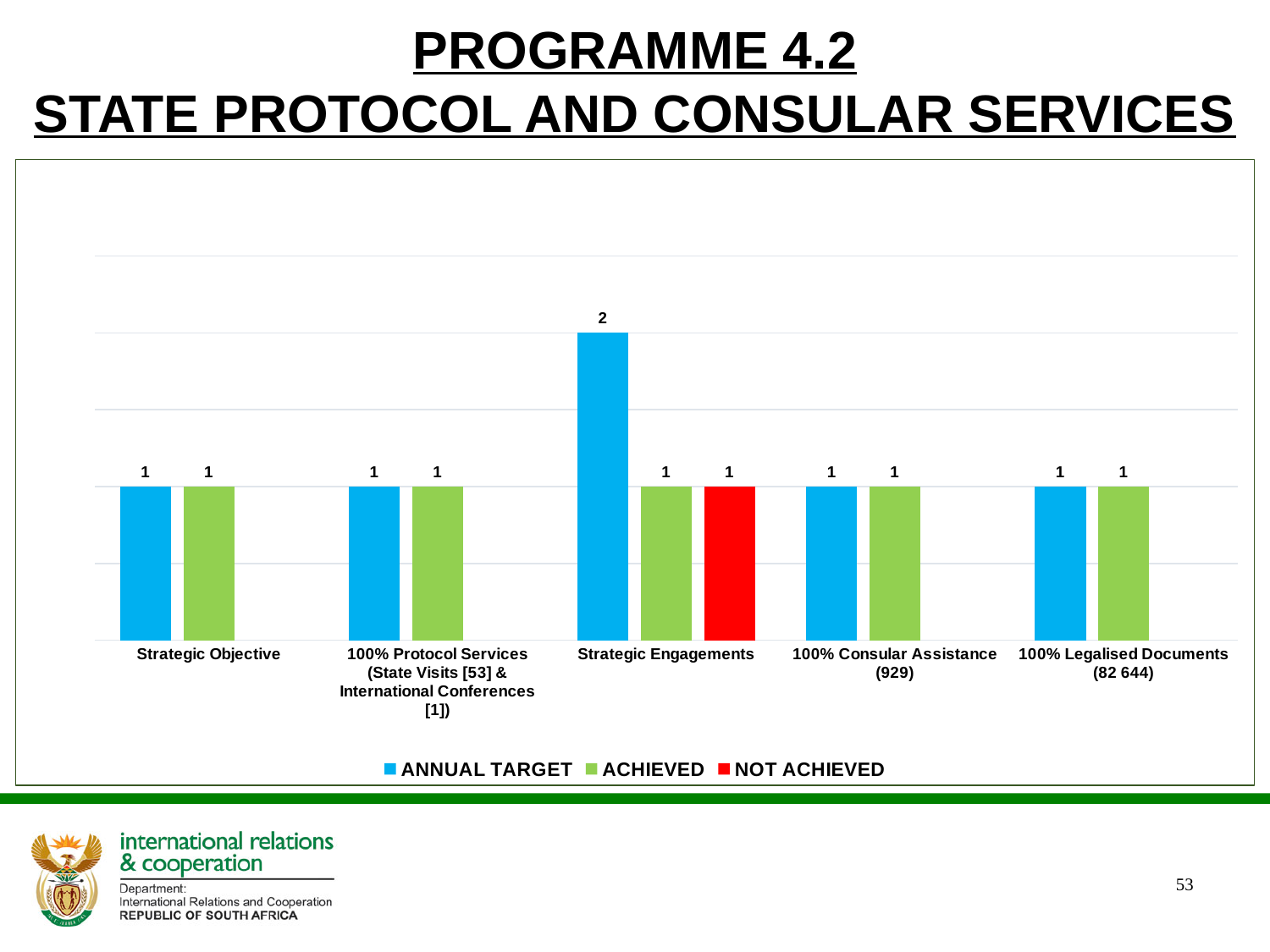
How many categories are shown on the x axis? 5 Which category is the only one with a NOT ACHIEVED bar? Strategic Engagements Which is larger for Strategic Engagements: the ANNUAL TARGET or the ACHIEVED value? ANNUAL TARGET Which category has the highest ANNUAL TARGET value? Strategic Engagements What is the ANNUAL TARGET value for Strategic Engagements? 2 What is the ANNUAL TARGET value for 100% Legalised Documents (82 644)? 1 What is the NOT ACHIEVED value for Strategic Engagements? 1 What is the difference between the ANNUAL TARGET and ACHIEVED values for Strategic Engagements? 1 What kind of chart is shown on the slide? Bar chart What is the ACHIEVED value for 100% Consular Assistance (929)? 1 What colour represents the ACHIEVED series in the legend? Green How many series does the legend list? 3